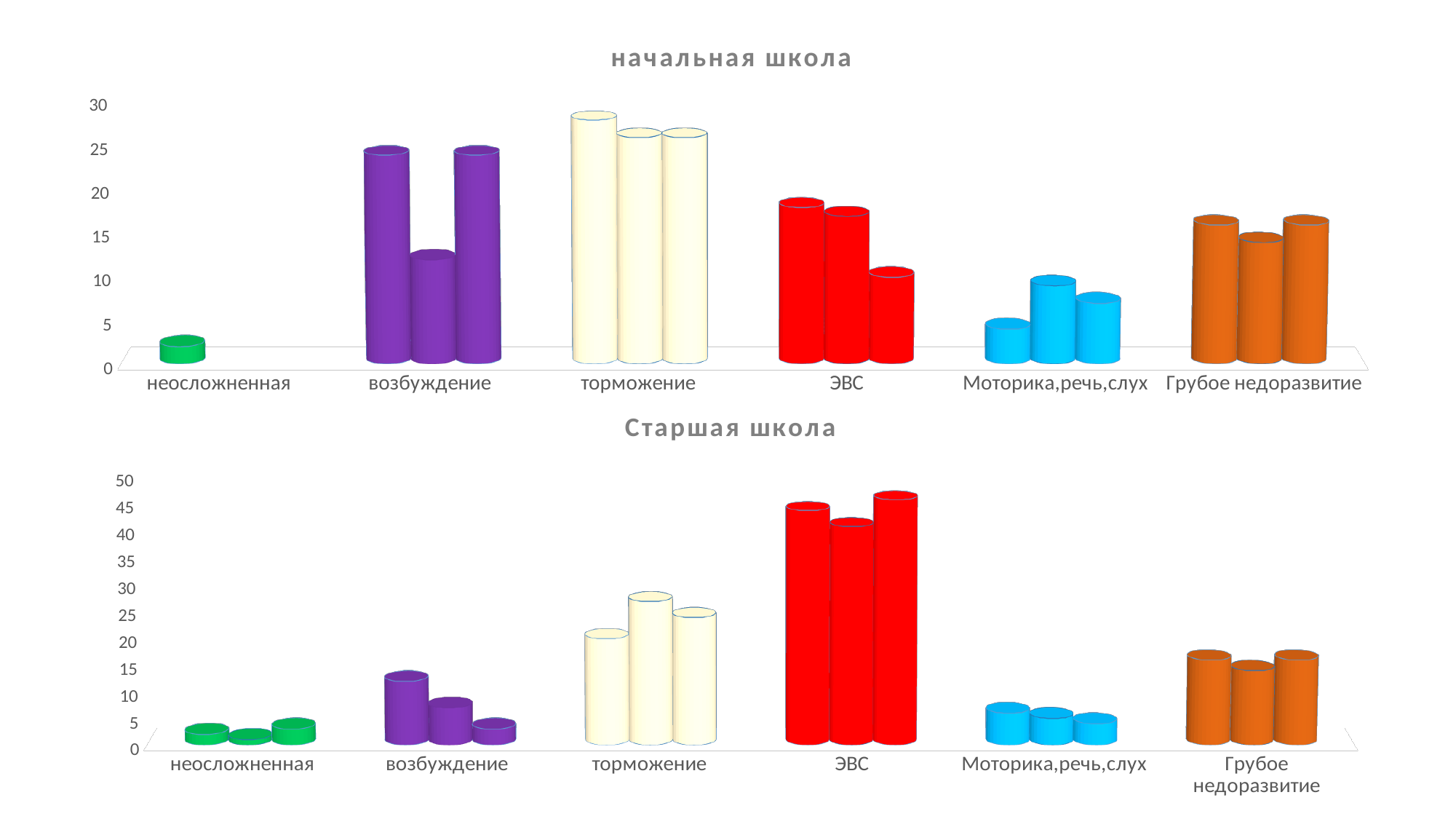
In the top chart "начальная школа", which category has the lowest bar? неосложненная In the top chart "начальная школа", is the value of the left bar for торможение greater or less than 25? greater In the top chart "начальная школа", which category has the tallest bars? торможение What kind of chart is the top chart titled "начальная школа"? bar chart In the top chart "начальная школа", is the value of the left bar for ЭВС greater or less than 20? less In the bottom chart "Старшая школа", which category has the lowest bars? неосложненная What is the title of the top chart on the slide? начальная школа How many categories are shown on the x axis of the bottom chart "Старшая школа"? 6 In the bottom chart "Старшая школа", is the value of the left bar for Моторика,речь,слух greater or less than 10? less In the bottom chart "Старшая школа", which category has the tallest bars? ЭВС In the bottom chart "Старшая школа", which category has taller bars: ЭВС or торможение? ЭВС